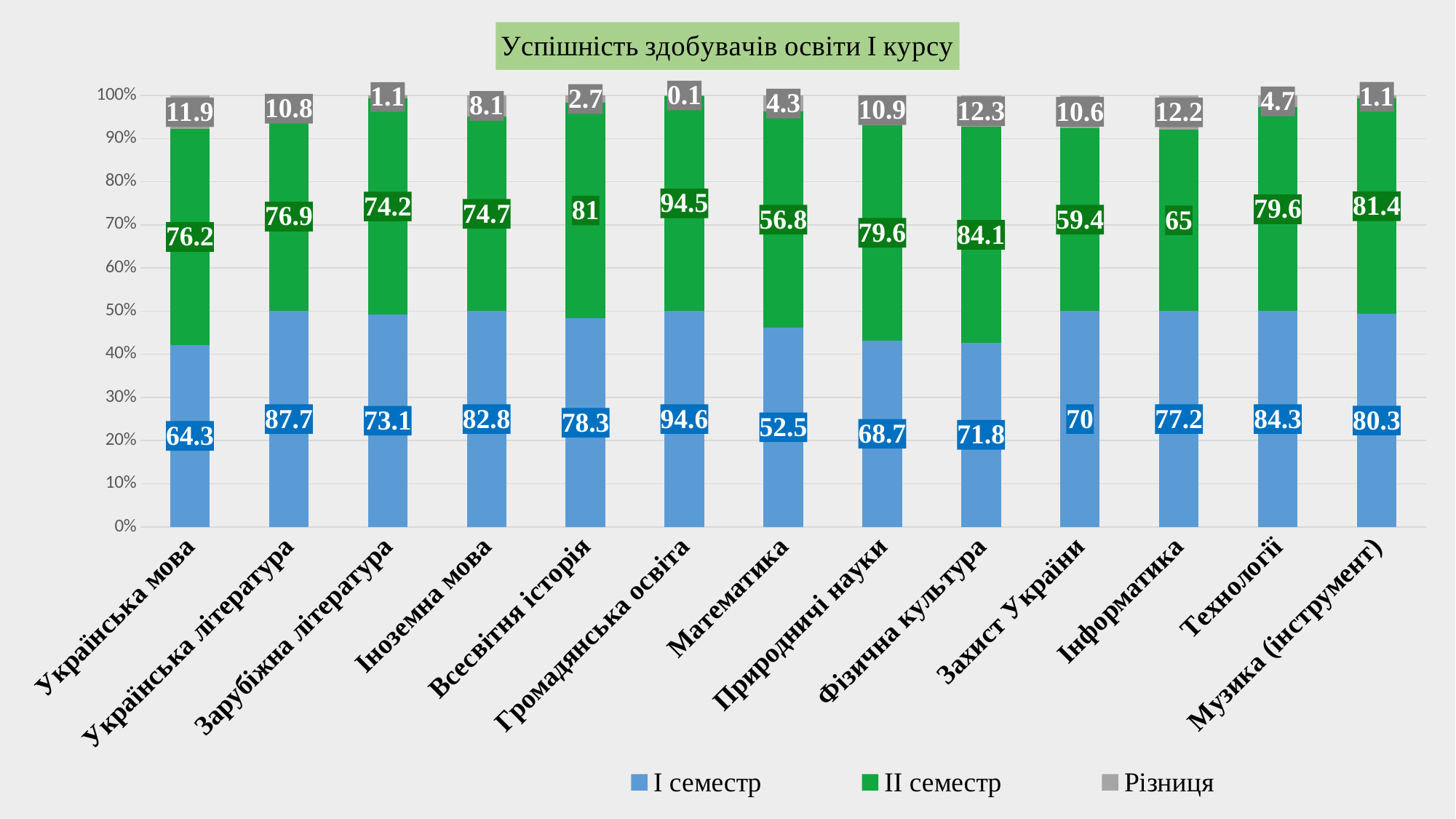
What is the difference between the I семестр and II семестр values for Українська література? 10.8 What is the II семестр value for Фізична культура? 84.1 How many subjects are shown on the x axis? 13 What is the Різниця value for Українська мова? 11.9 Which subject has the highest Різниця value? Фізична культура What is the I семестр value for Математика? 52.5 Which subject has the lowest II семестр value? Математика What type of chart is shown? Stacked bar chart For Захист України, which is larger: the I семестр value or the II семестр value? I семестр How many series does the legend list? 3 Which subject has the highest I семестр value? Громадянська освіта Which subject has the lowest Різниця value? Громадянська освіта